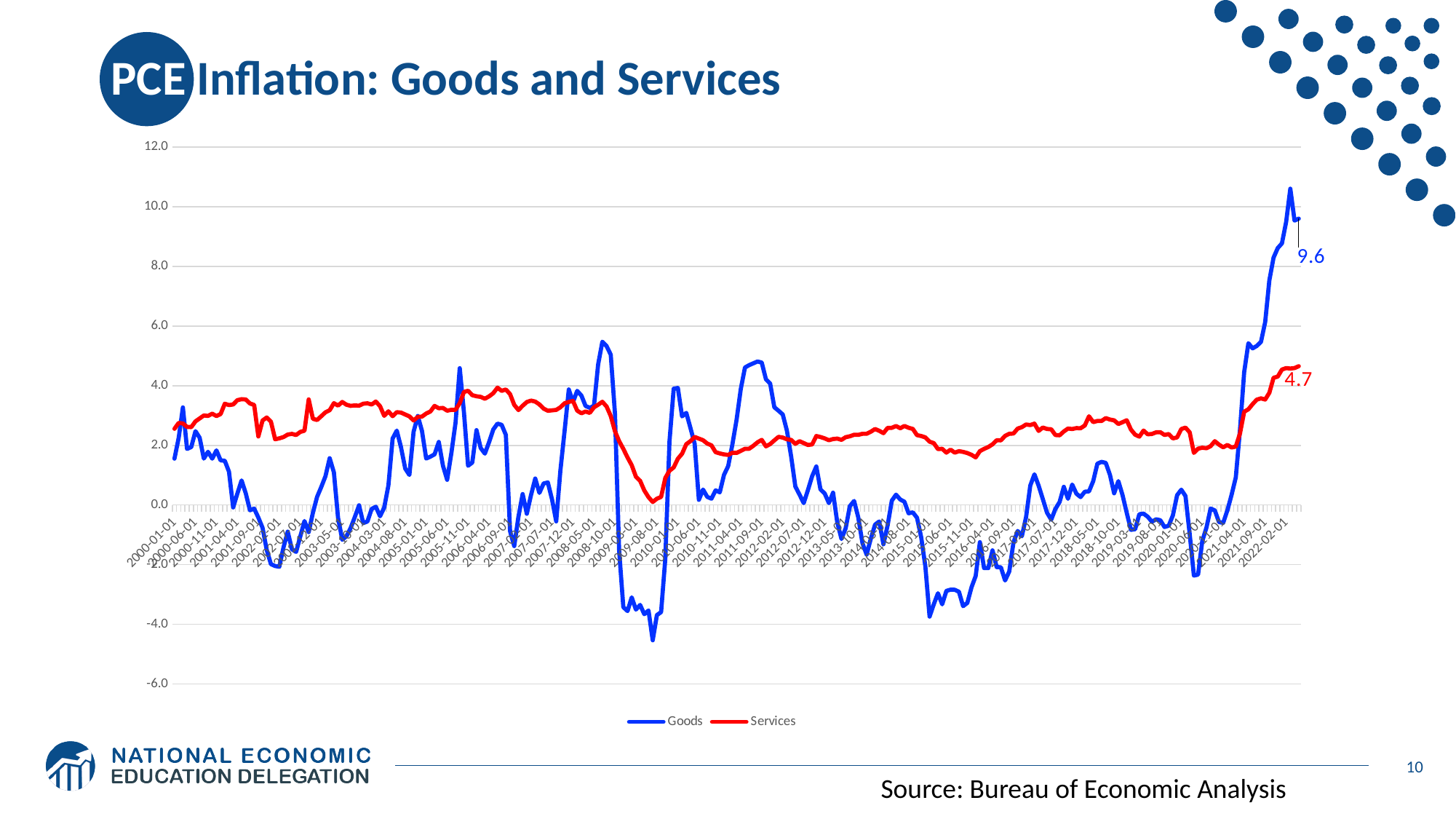
Is the peak value of the Goods series in 2021-2022 greater or less than 10.0? greater What is the labelled final value of the Goods series? 9.6 Is the value for Goods around 2009-08-01 greater or less than -2.0? less Is the value for Services around 2009-08-01 greater or less than 2.0? less What colour is the Goods line in the chart? Blue What is the labelled final value of the Services series? 4.7 What kind of chart is shown on the slide? Line chart What is the difference between the labelled final values of Goods (9.6) and Services (4.7)? 4.9 What is the title of the chart on the slide? PCE Inflation: Goods and Services Does the Goods series rise or fall between 2020-06-01 and 2022-02-01? Rise At the end of the series, which is larger: Goods or Services? Goods How many series does the legend list? 2